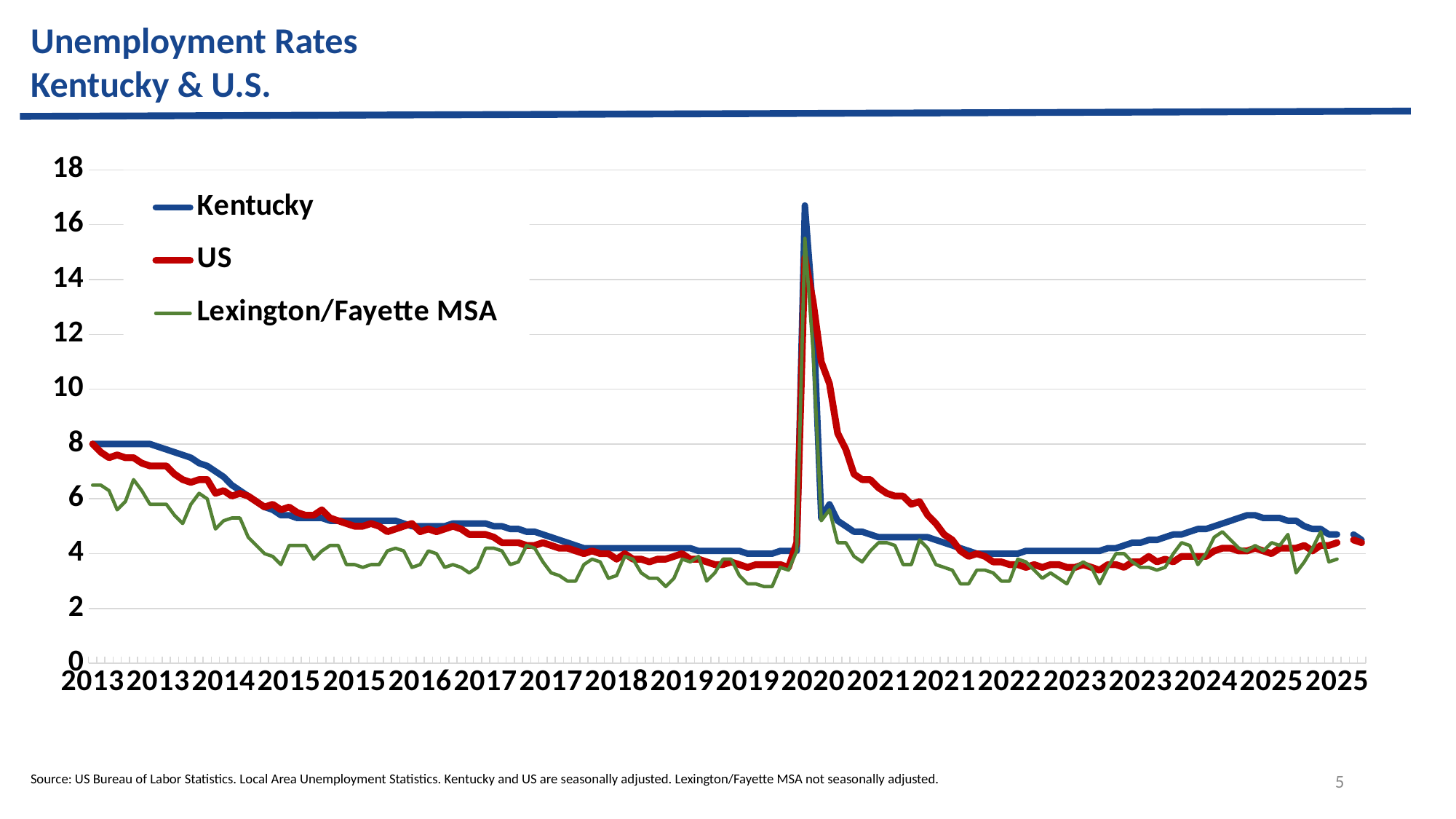
What kind of chart is shown on the slide? line chart Which series reaches the highest peak in 2020? Kentucky Is the peak value for US in 2020 greater or less than 16? less How many series does the legend list? 3 Which series is lowest during 2018? Lexington/Fayette MSA At the start of 2013, which is higher: Kentucky or Lexington/Fayette MSA? Kentucky Does the Kentucky unemployment rate rise or fall from 2013 to 2019? fall Is the value for Kentucky at the start of 2013 greater or less than 6? greater Is the peak value for Kentucky in 2020 greater or less than 16? greater Which colour is used for the US series? red What is the title of the chart on the slide? Unemployment Rates Kentucky & U.S. What is the highest value shown on the vertical axis? 18